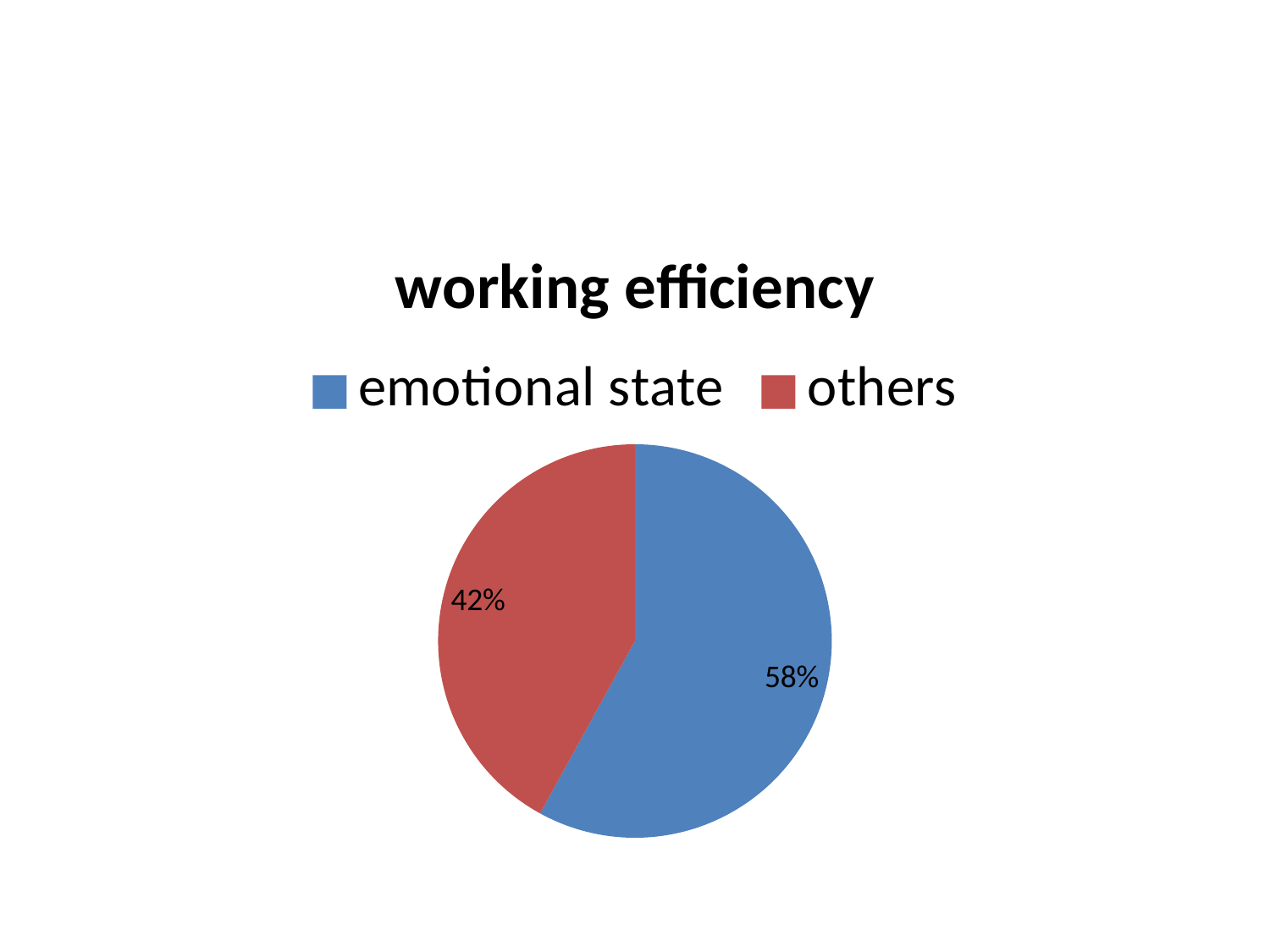
What colour is the 'others' slice? red How many slices does the pie chart have? 2 Which slice is the largest? emotional state How many entries does the legend list? 2 What share of the pie does 'others' take? 42% Which is larger, the 'emotional state' slice or the 'others' slice? emotional state What share of the pie does 'emotional state' take? 58% What kind of chart is shown on the slide? pie chart Which slice is the smallest? others What is the title of the chart? working efficiency What is the difference in percentage points between 'emotional state' and 'others'? 16